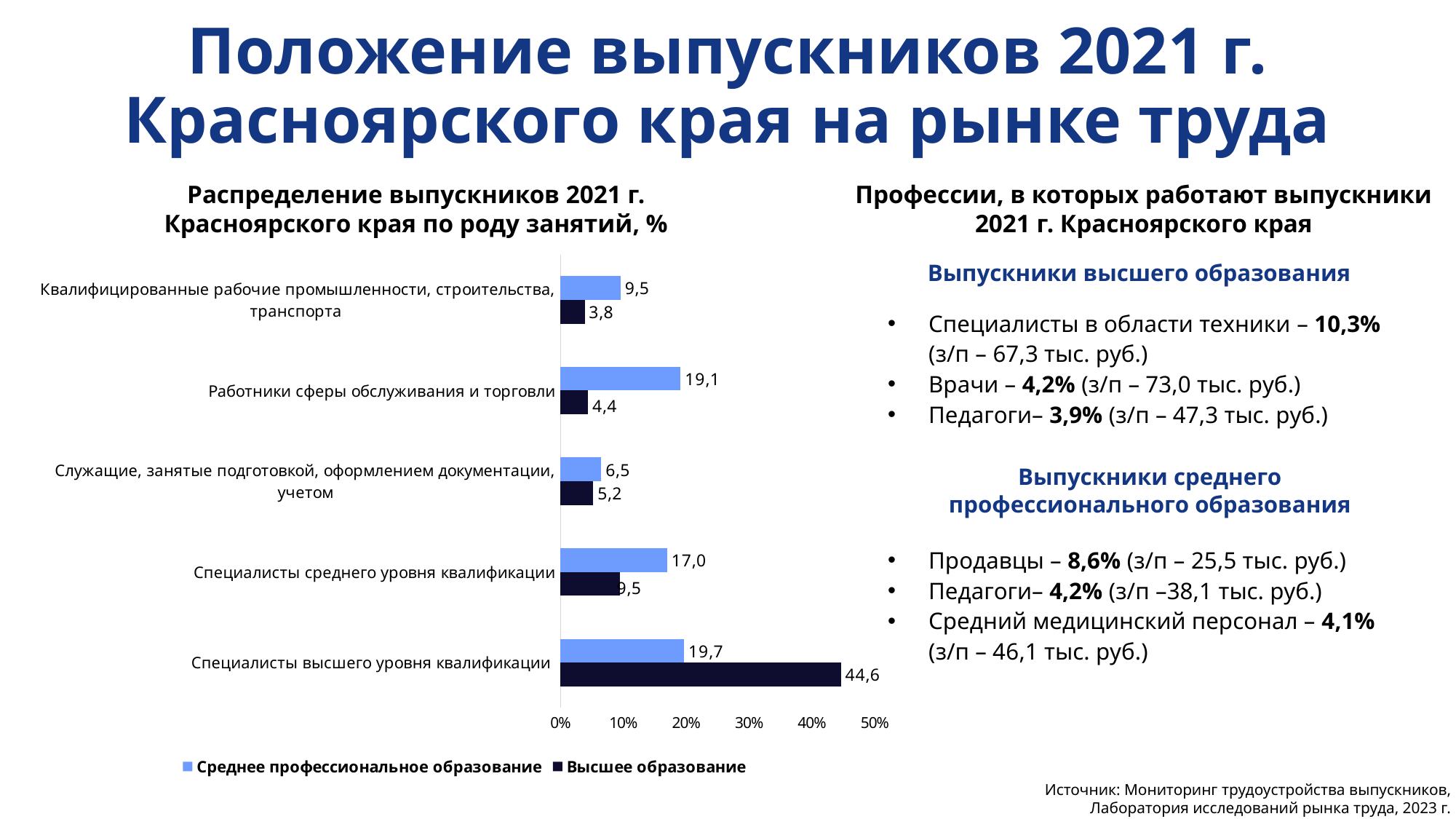
What is the difference between the "Высшее образование" and "Среднее профессиональное образование" values for "Специалисты высшего уровня квалификации"? 24,9 How many occupation categories are shown in the chart? 5 Which category has the lowest value for "Среднее профессиональное образование"? Служащие, занятые подготовкой, оформлением документации, учетом What is the value for "Среднее профессиональное образование" in the category "Работники сферы обслуживания и торговли"? 19,1 What colour are the bars for the "Высшее образование" series? Dark navy What type of chart is shown on the slide? Bar chart For "Специалисты среднего уровня квалификации", which series has the larger value: "Среднее профессиональное образование" or "Высшее образование"? Среднее профессиональное образование Which category has the highest value for "Высшее образование"? Специалисты высшего уровня квалификации What is the value for "Высшее образование" in the category "Служащие, занятые подготовкой, оформлением документации, учетом"? 5,2 How many series does the chart legend list? 2 Is the "Высшее образование" value for "Специалисты высшего уровня квалификации" greater or less than 40%? greater What is the value for "Высшее образование" in the category "Специалисты высшего уровня квалификации"? 44,6